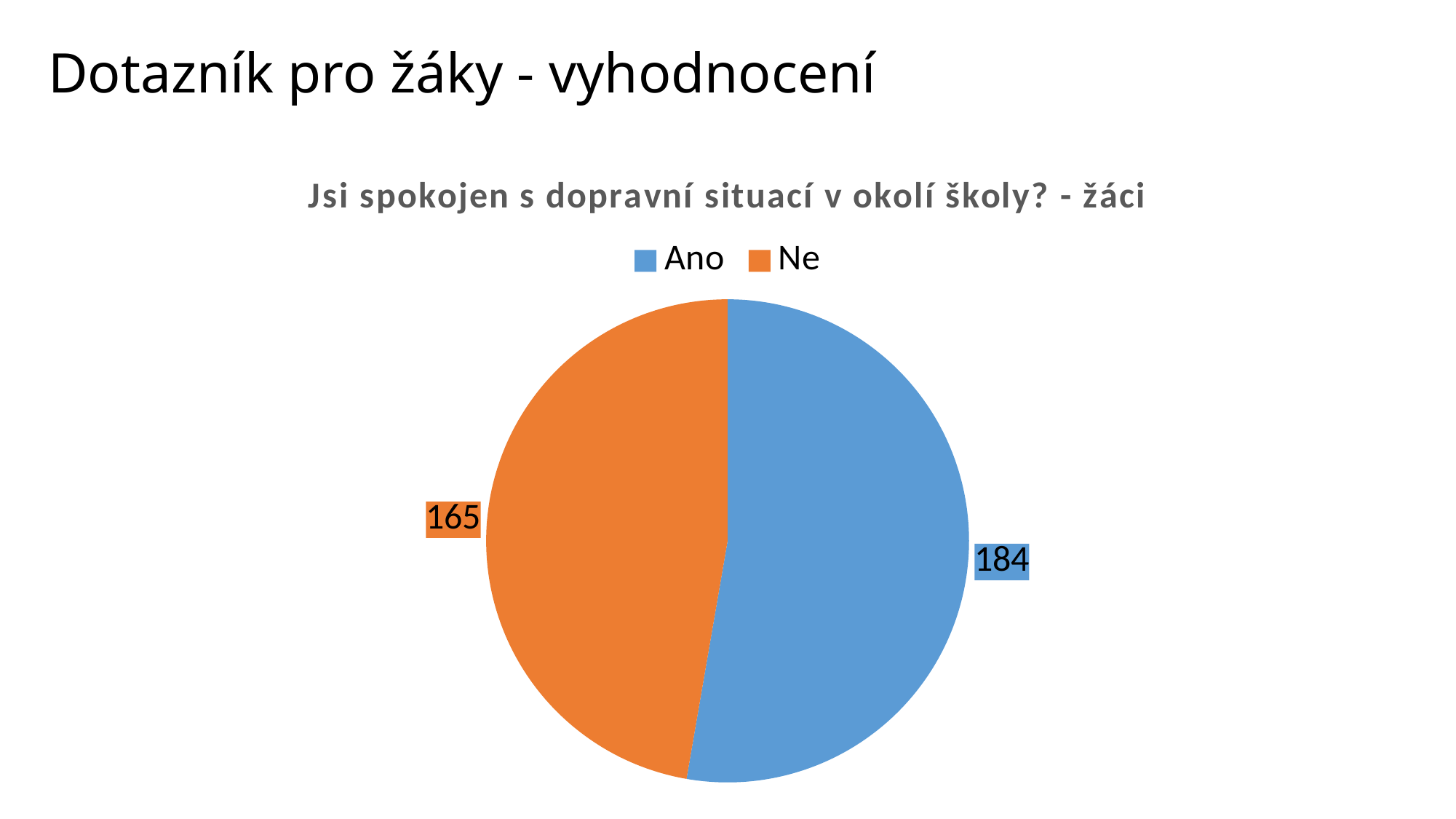
How many slices does the pie chart have? 2 Which category has the largest slice? Ano How many entries does the legend list? 2 What kind of chart is shown on the slide? pie chart What is the title of the chart? Jsi spokojen s dopravní situací v okolí školy? - žáci What is the difference between the values for "Ano" and "Ne"? 19 Which is larger, the value for "Ano" or the value for "Ne"? Ano What is the total of all slices in the pie chart? 349 What is the value for "Ano"? 184 What is the value for "Ne"? 165 Which category has the smallest slice? Ne